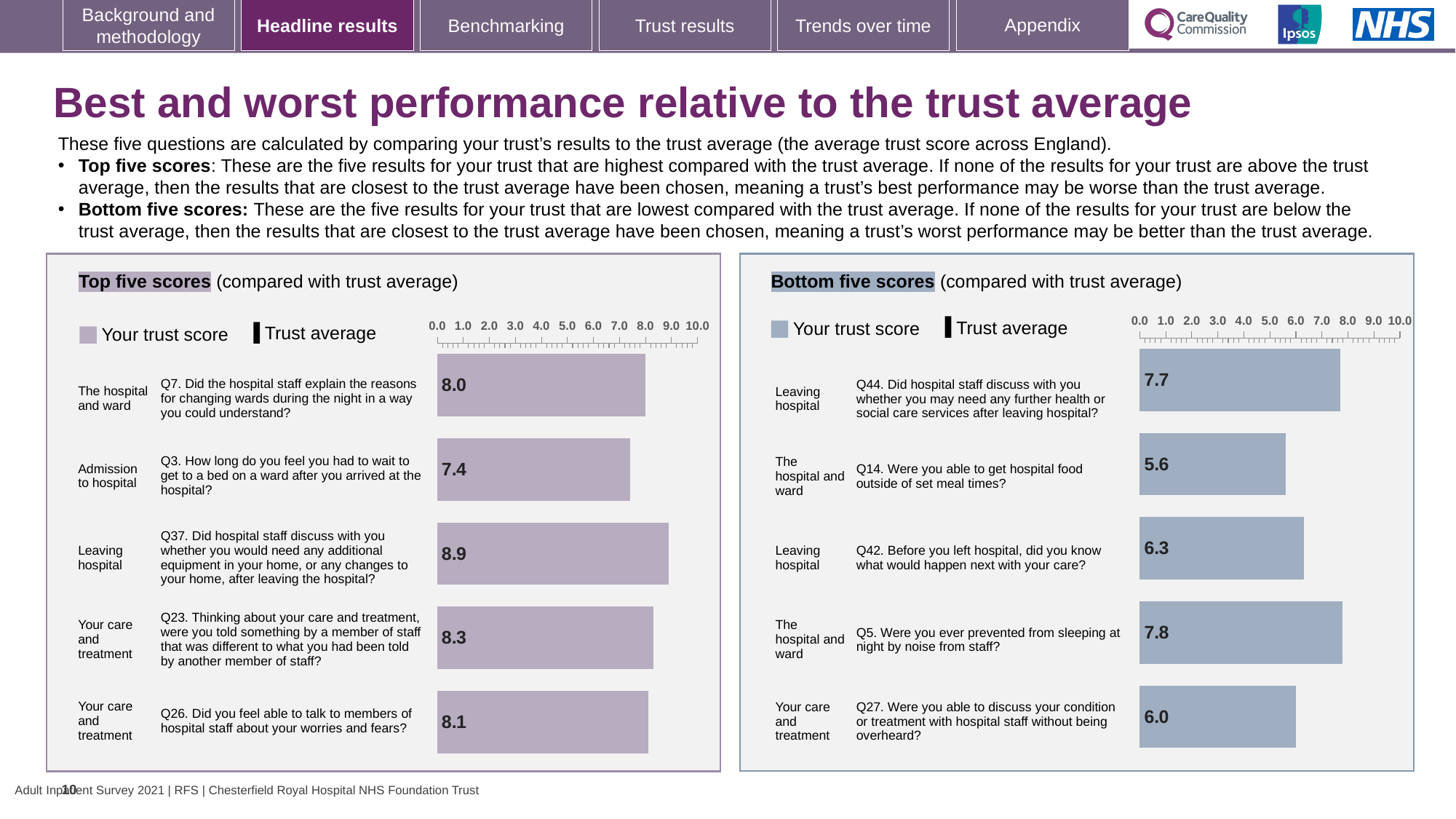
What type of chart is used in the Top five scores panel? Bar chart In the Top five scores chart, which question has the lowest trust score? Q3 In the Bottom five scores chart, what is the difference between the scores for Q5 and Q27? 1.8 In the Bottom five scores chart, which question has the lowest trust score? Q14 In the Top five scores chart, what is the trust score for Q7 about staff explaining the reasons for changing wards during the night? 8.0 In the Top five scores chart, which question has the highest trust score? Q37 In the Top five scores chart, which has the larger score: Q23 or Q26? Q23 How many series does the legend of the Bottom five scores chart list? 2 How many questions are shown in the Bottom five scores chart? 5 In the Top five scores chart, what is the trust score for Q37 about discussing additional equipment or changes to your home after leaving hospital? 8.9 In the Bottom five scores chart, what is the trust score for Q14 about getting hospital food outside of set meal times? 5.6 In the Bottom five scores chart, what is the trust score for Q5 about being prevented from sleeping at night by noise from staff? 7.8